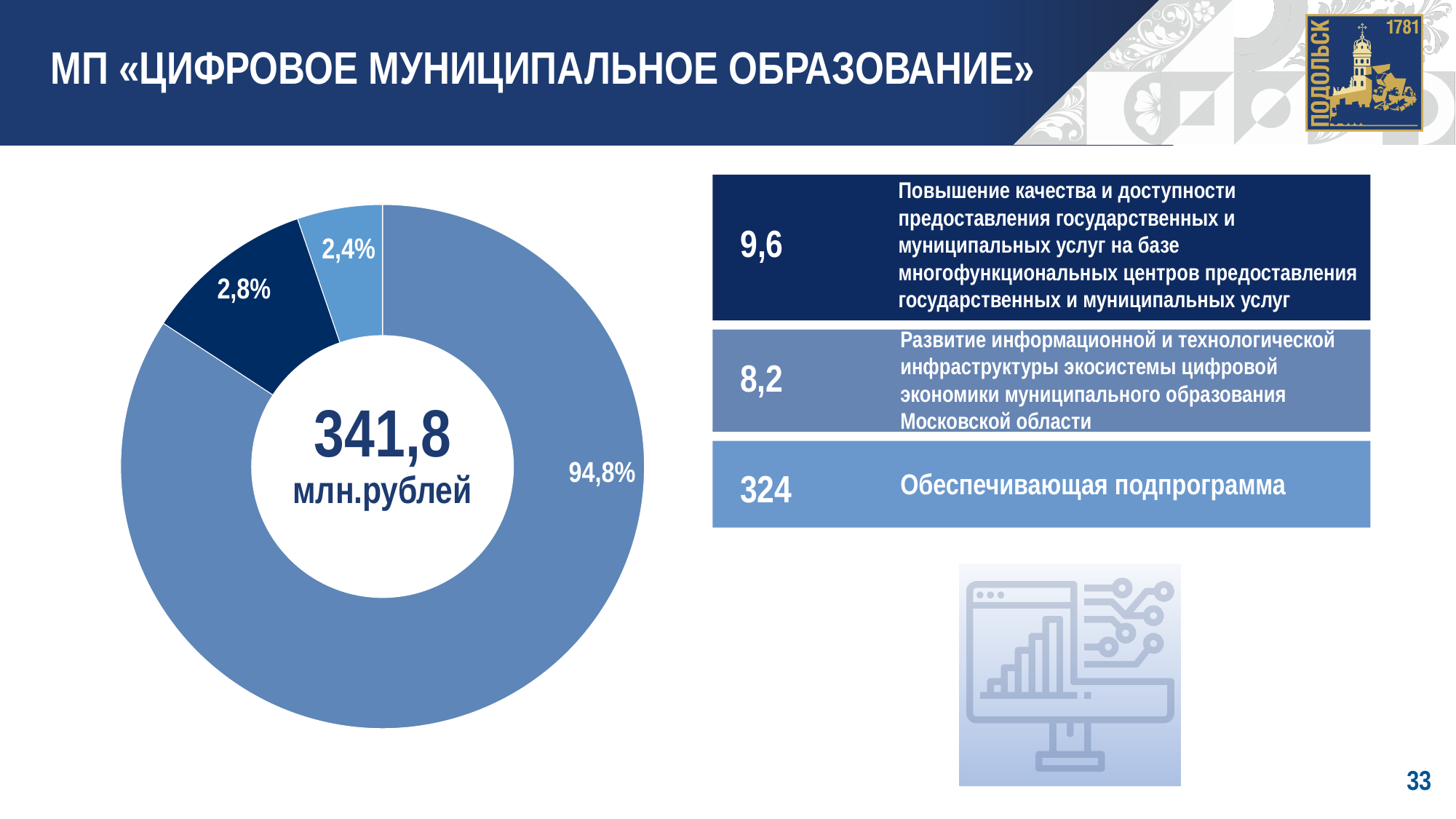
What is the share of the largest slice in the pie chart? 94,8% What total value is printed in the centre of the pie chart? 341,8 млн.рублей What is the share of the smallest slice in the pie chart? 2,4% What is the title of the slide containing the pie chart? МП «ЦИФРОВОЕ МУНИЦИПАЛЬНОЕ ОБРАЗОВАНИЕ» Which is larger: the dark navy slice or the light blue slice? the dark navy slice (2,8%) What do the three slice percentages of the pie chart add up to? 100% Is the largest slice of the pie chart greater or less than 90%? greater What value is shown next to «Обеспечивающая подпрограмма» in the boxes to the right of the chart? 324 What is the difference between the 2,8% slice and the 2,4% slice? 0,4% What kind of chart is shown on the slide? doughnut chart How many slices does the pie chart have? 3 What is the difference between the largest slice (94,8%) and the 2,8% slice? 92%